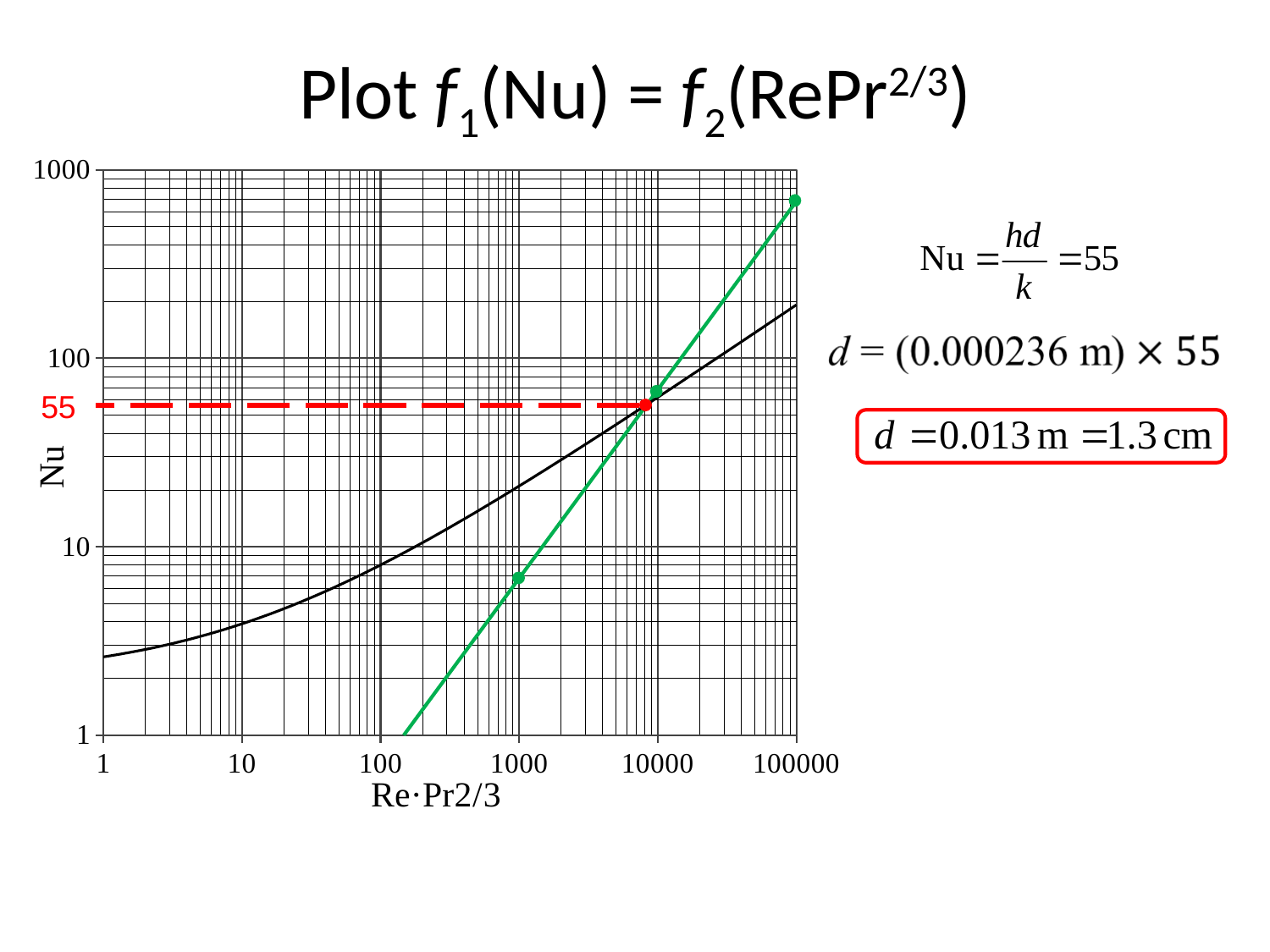
What Nu value is marked by the red dashed horizontal line? 55 Does the black curve rise or fall as Re·Pr2/3 increases? rises Is the value of the green line at Re·Pr2/3 = 1000 greater or less than 10? less What kind of chart is shown on the slide? line chart What is the label of the y axis? Nu Is the value of the black curve at Re·Pr2/3 = 100000 greater or less than 1000? less At Re·Pr2/3 = 100000, which is higher, the green line or the black curve? the green line How many marked points are shown on the green line? 3 At Re·Pr2/3 = 1000, which is higher, the green line or the black curve? the black curve Is the value of the green line at Re·Pr2/3 = 100000 greater or less than 100? greater What is the label of the x axis? Re·Pr2/3